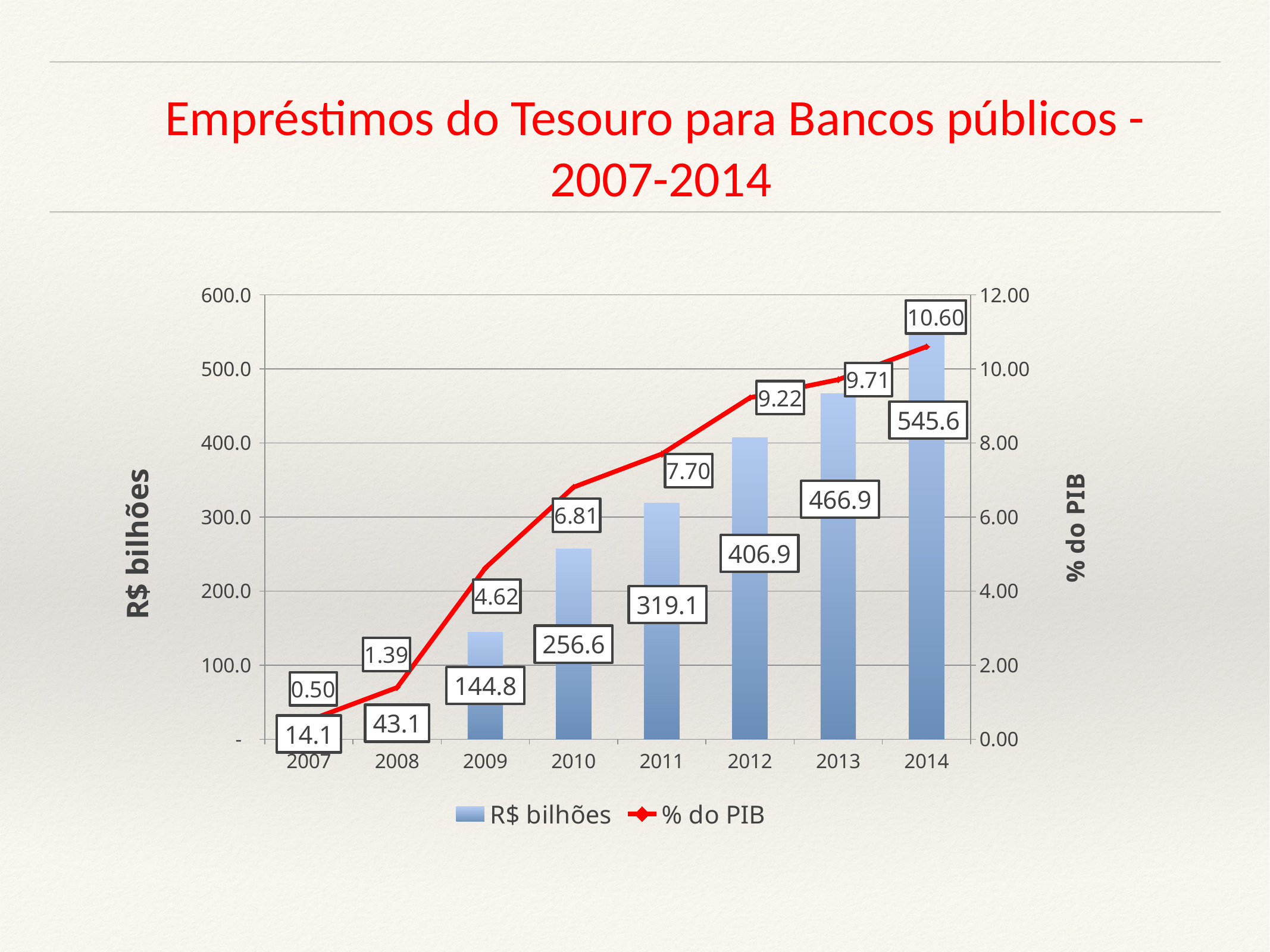
How many years are shown on the x axis? 8 What is the R$ bilhões value for 2007? 14.1 Which year has the lowest % do PIB value? 2007 Which year has the highest R$ bilhões value? 2014 What is the difference in R$ bilhões between 2014 and 2013? 78.7 What kind of chart is used for the R$ bilhões series? bar chart Which is larger, the R$ bilhões value for 2011 or for 2012? 2012 What is the R$ bilhões value for 2010? 256.6 Do the % do PIB values rise or fall from 2007 to 2014? rise What is the title of the chart on the slide? Empréstimos do Tesouro para Bancos públicos - 2007-2014 What is the % do PIB value for 2012? 9.22 How many series does the legend list? 2